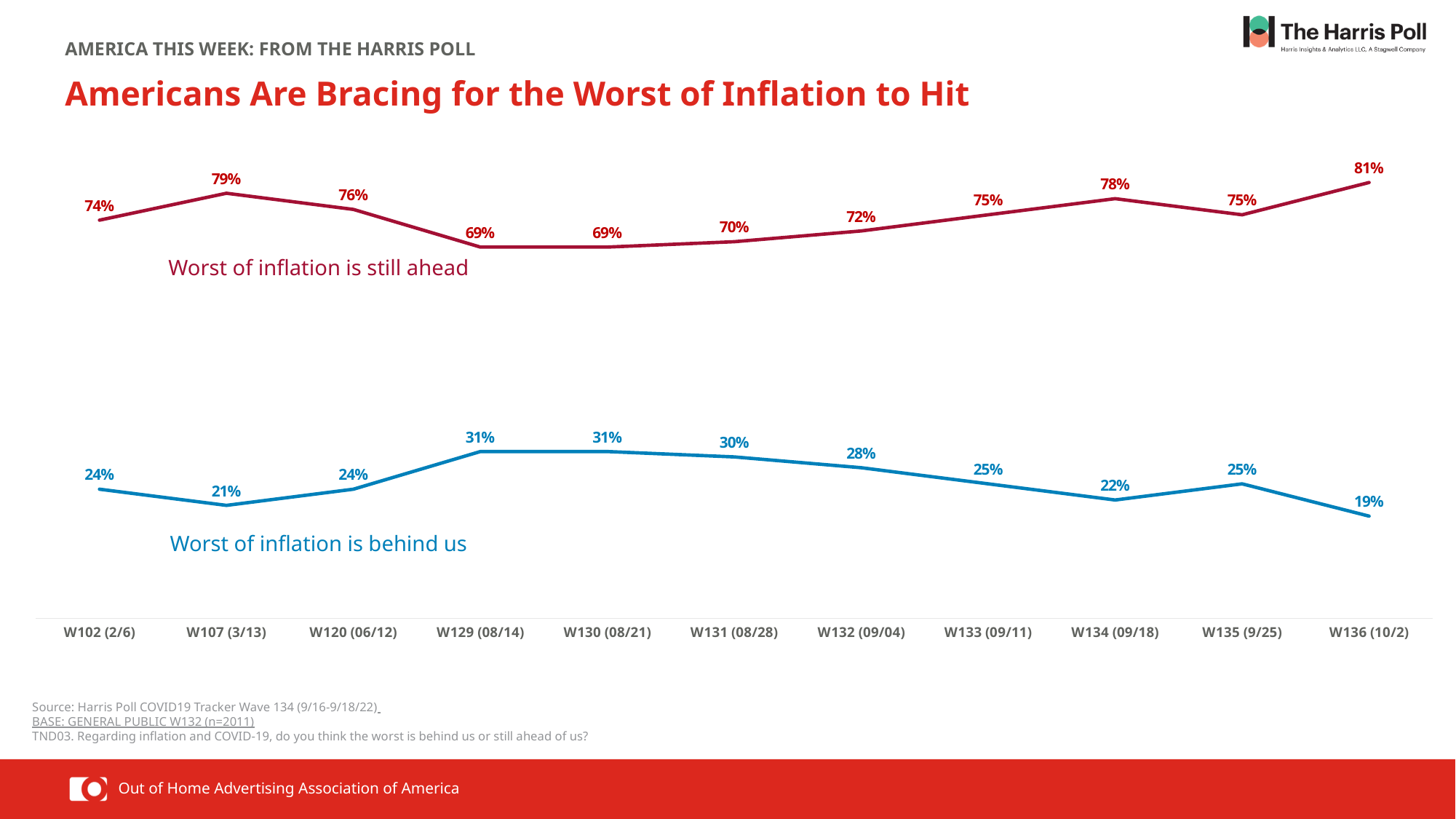
Which is larger in W107 (3/13): 'Worst of inflation is still ahead' or 'Worst of inflation is behind us'? Worst of inflation is still ahead In which wave does 'Worst of inflation is still ahead' reach its highest value? W136 (10/2) In which wave is 'Worst of inflation is behind us' at its lowest? W136 (10/2) How many waves are shown on the x axis? 11 How many series are plotted on the chart? 2 In which wave is 'Worst of inflation is still ahead' at its lowest? W129 (08/14) and W130 (08/21), both 69% What type of chart is shown on the slide? Line chart How much did 'Worst of inflation is still ahead' change from W135 (9/25) to W136 (10/2)? Increased by 6 percentage points What is the value for 'Worst of inflation is still ahead' at W102 (2/6)? 74% What percentage said the worst of inflation is behind us in W129 (08/14)? 31% What is the difference between 'still ahead' and 'behind us' in W136 (10/2)? 62 percentage points What percentage said the worst of inflation is still ahead in W136 (10/2)? 81%